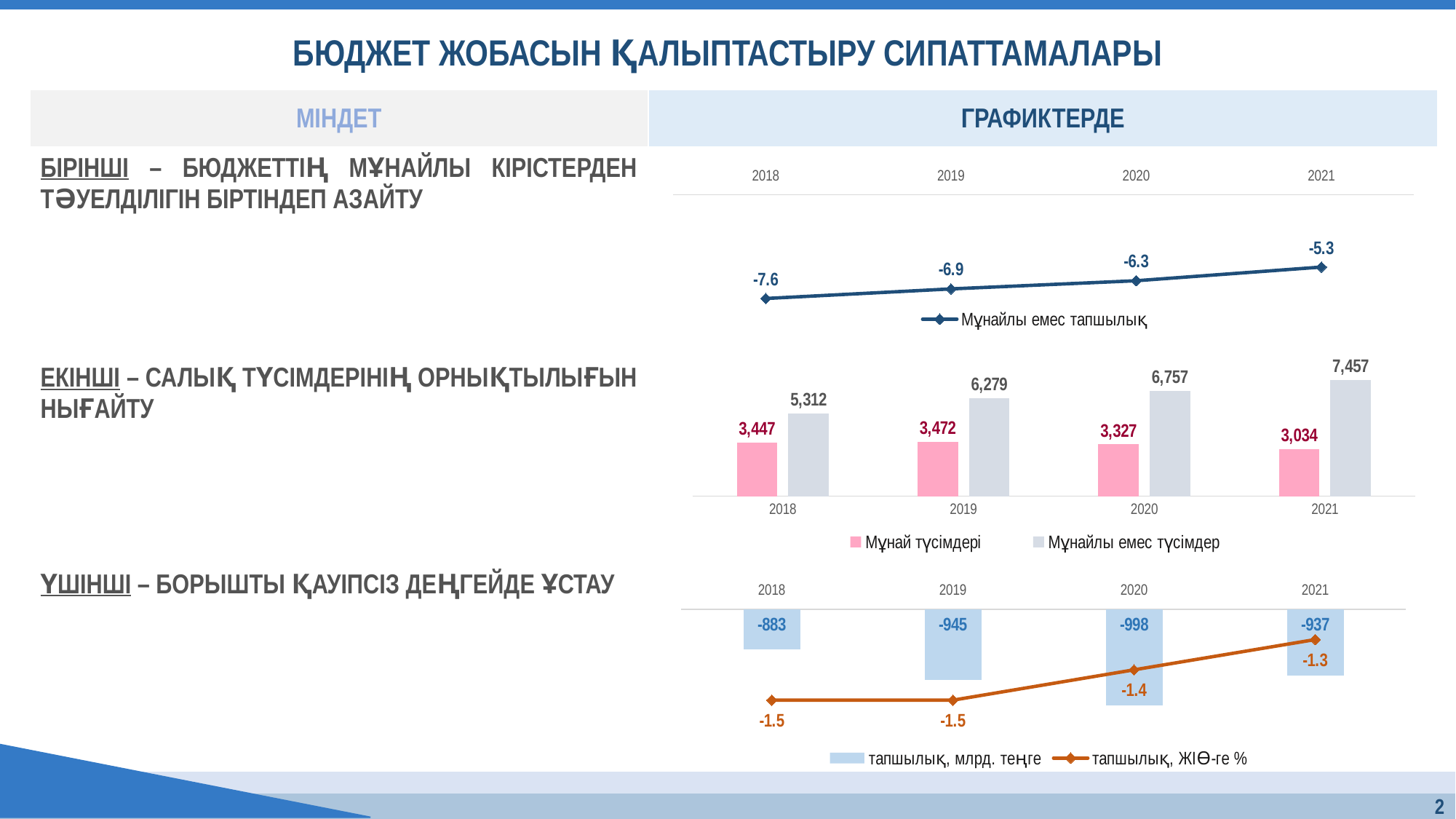
In the bottom chart, what is the value of тапшылық, млрд. теңге for 2020? -998 In the middle bar chart, which year has the lowest value for Мұнай түсімдері? 2021 In the middle bar chart, how many series does the legend list? 2 In the middle bar chart, what is the value of Мұнай түсімдері for 2021? 3,034 In the middle bar chart, what is the value of Мұнайлы емес түсімдер for 2020? 6,757 In the top chart (Мұнайлы емес тапшылық), what is the value for 2021? -5.3 In the top chart (Мұнайлы емес тапшылық), what is the value for 2018? -7.6 In the middle bar chart, which year has the highest value for Мұнайлы емес түсімдер? 2021 In the top chart (Мұнайлы емес тапшылық), do the values rise or fall from 2018 to 2021? rise In the bottom chart, what is the value of тапшылық, ЖІӨ-ге % for 2021? -1.3 In the middle bar chart, what is the difference between Мұнайлы емес түсімдер and Мұнай түсімдері in 2018? 1,865 In the top chart (Мұнайлы емес тапшылық), how many data points are plotted? 4